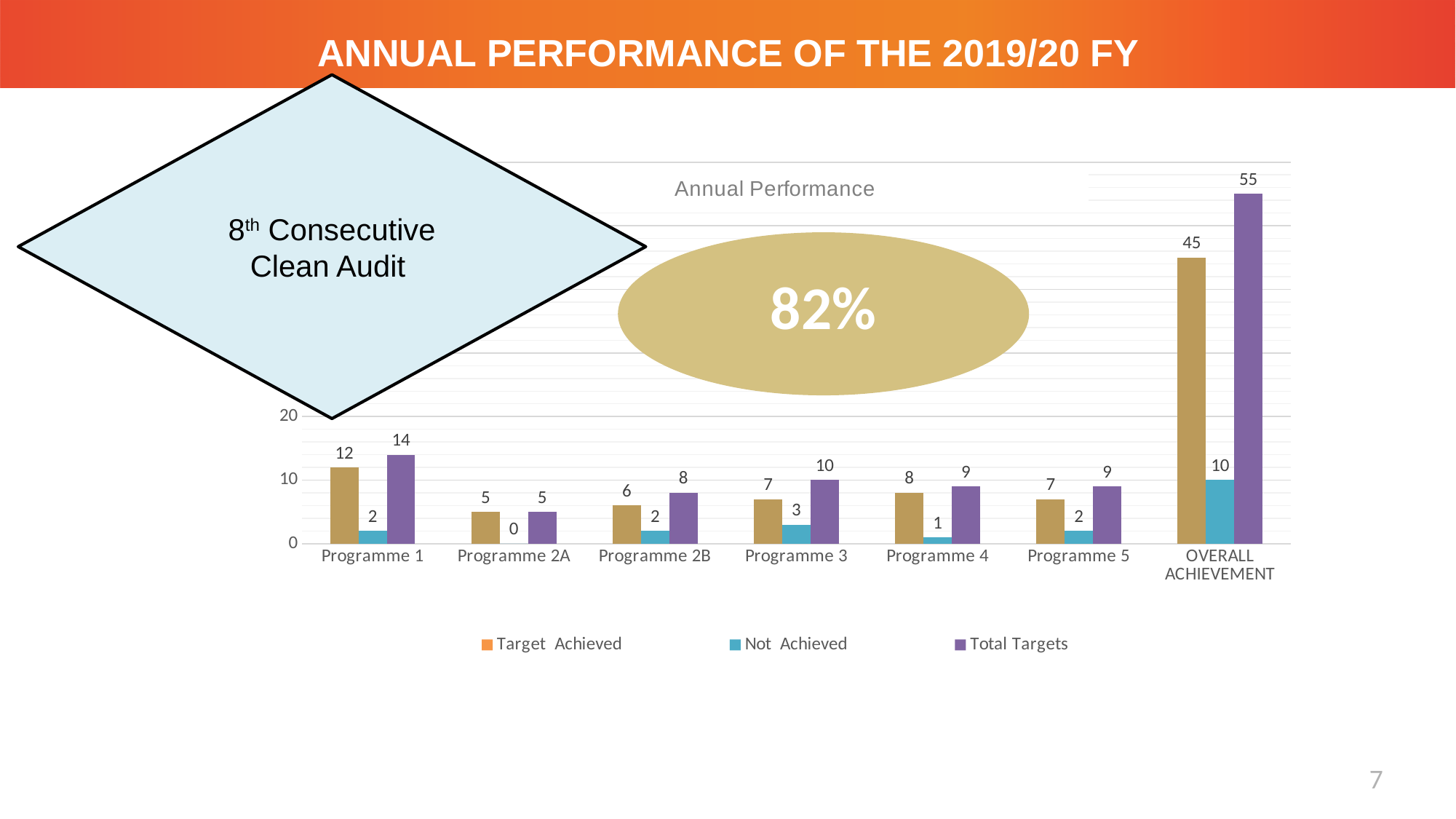
What is the Not Achieved value for Programme 3? 3 What is the difference between Total Targets and Target Achieved for Programme 1? 2 What is the title of the chart? Annual Performance Which is larger for Programme 4: Target Achieved or Not Achieved? Target Achieved Which category has the highest Total Targets value? OVERALL ACHIEVEMENT How many series does the legend list? 3 What is the Total Targets value for OVERALL ACHIEVEMENT? 55 Which programme has the lowest Not Achieved value? Programme 2A What kind of chart is shown on the slide? bar chart Is the Target Achieved value for OVERALL ACHIEVEMENT greater or less than 20? greater How many categories are shown on the x axis? 7 What is the Target Achieved value for Programme 1? 12